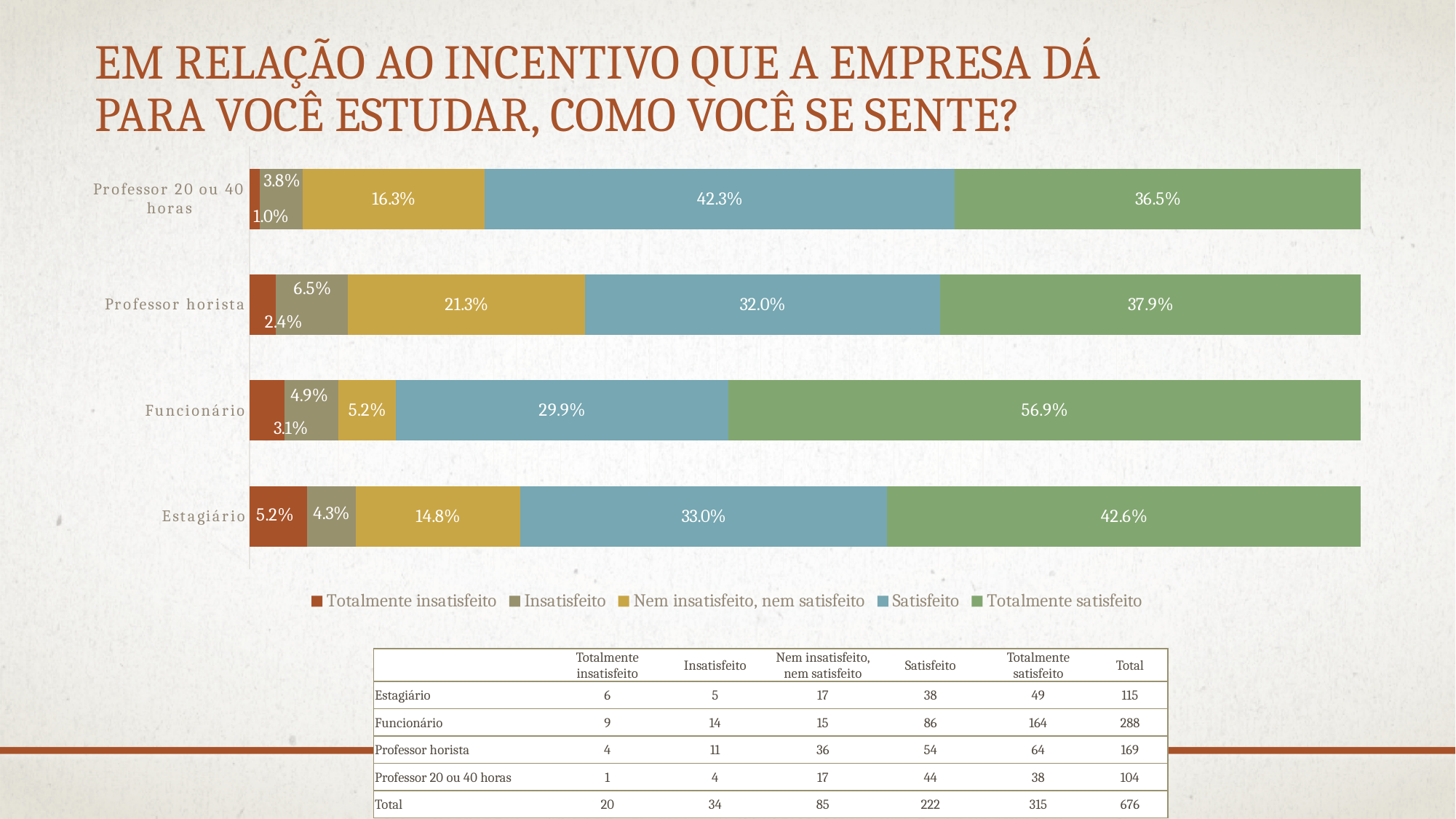
How many percentage points higher is the 'Totalmente satisfeito' value for Funcionário than for Estagiário? 14.3 percentage points Which category has the lowest 'Totalmente insatisfeito' percentage? Professor 20 ou 40 horas Which category has the highest 'Totalmente satisfeito' percentage? Funcionário What colour represents 'Totalmente satisfeito' in the chart? Green What kind of chart is shown on the slide? Stacked bar chart How many categories (bars) are shown in the chart? 4 What is the 'Satisfeito' value for Professor 20 ou 40 horas? 42.3% What percentage of Funcionário respondents are 'Totalmente satisfeito'? 56.9% How many series does the legend list? 5 What is the 'Insatisfeito' value for Estagiário? 4.3% What is the 'Nem insatisfeito, nem satisfeito' value for Professor horista? 21.3% Which has a larger 'Satisfeito' value, Professor horista or Estagiário? Estagiário